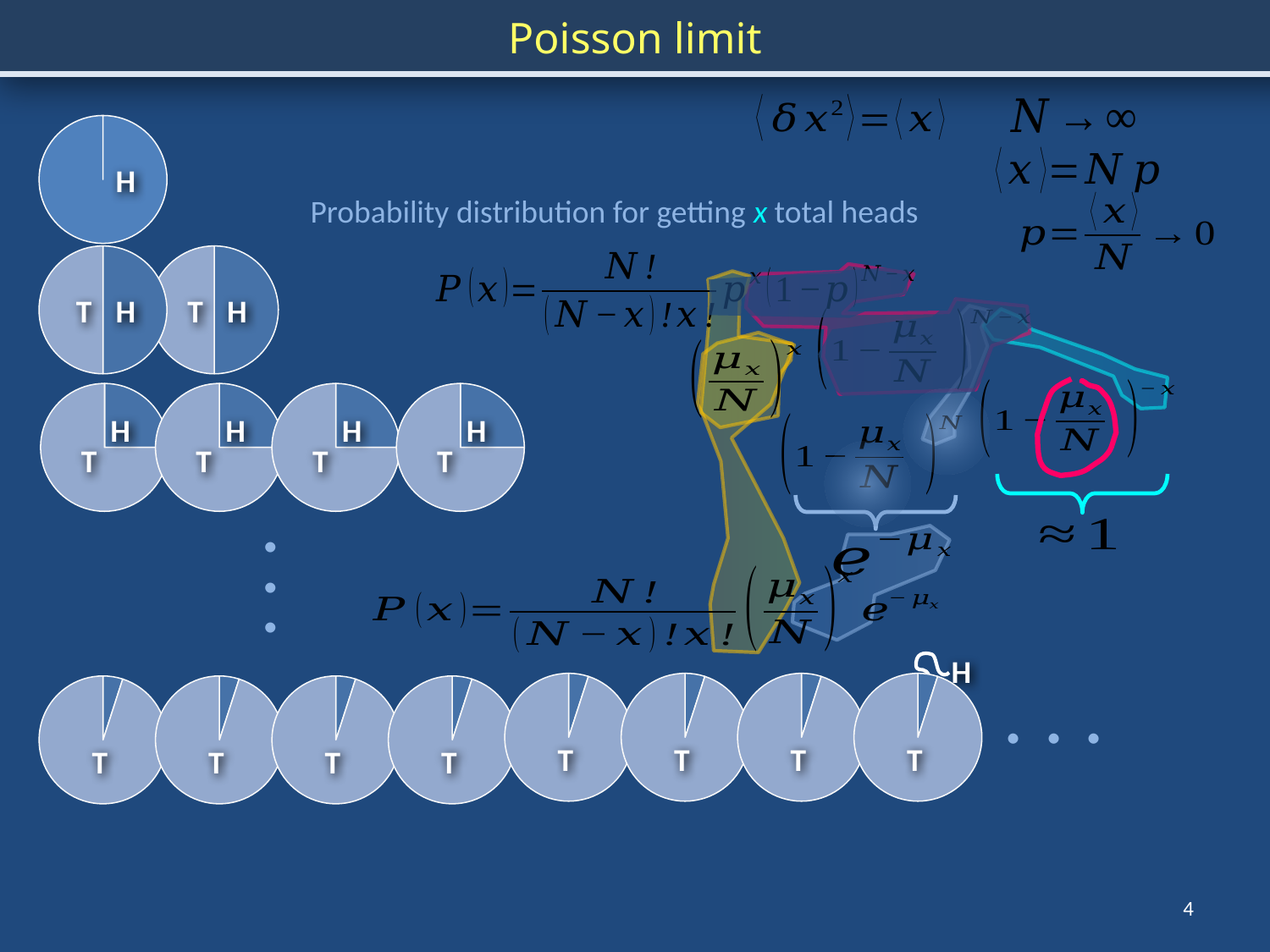
How many pie charts are in the third row (the row with four coins)? 4 How many pie charts are in the top row of the slide? 1 What kind of chart is used to represent each coin on the slide? pie chart In the third row of pie charts (four coins), which slice is larger, H or T? T What two slice labels appear in the pie charts in the second row? T and H How many pie charts are shown in the bottom row before the ellipsis? 8 What label appears in the single pie chart at the top left of the slide? H In the bottom row of pie charts, which slice is larger, H or T? T